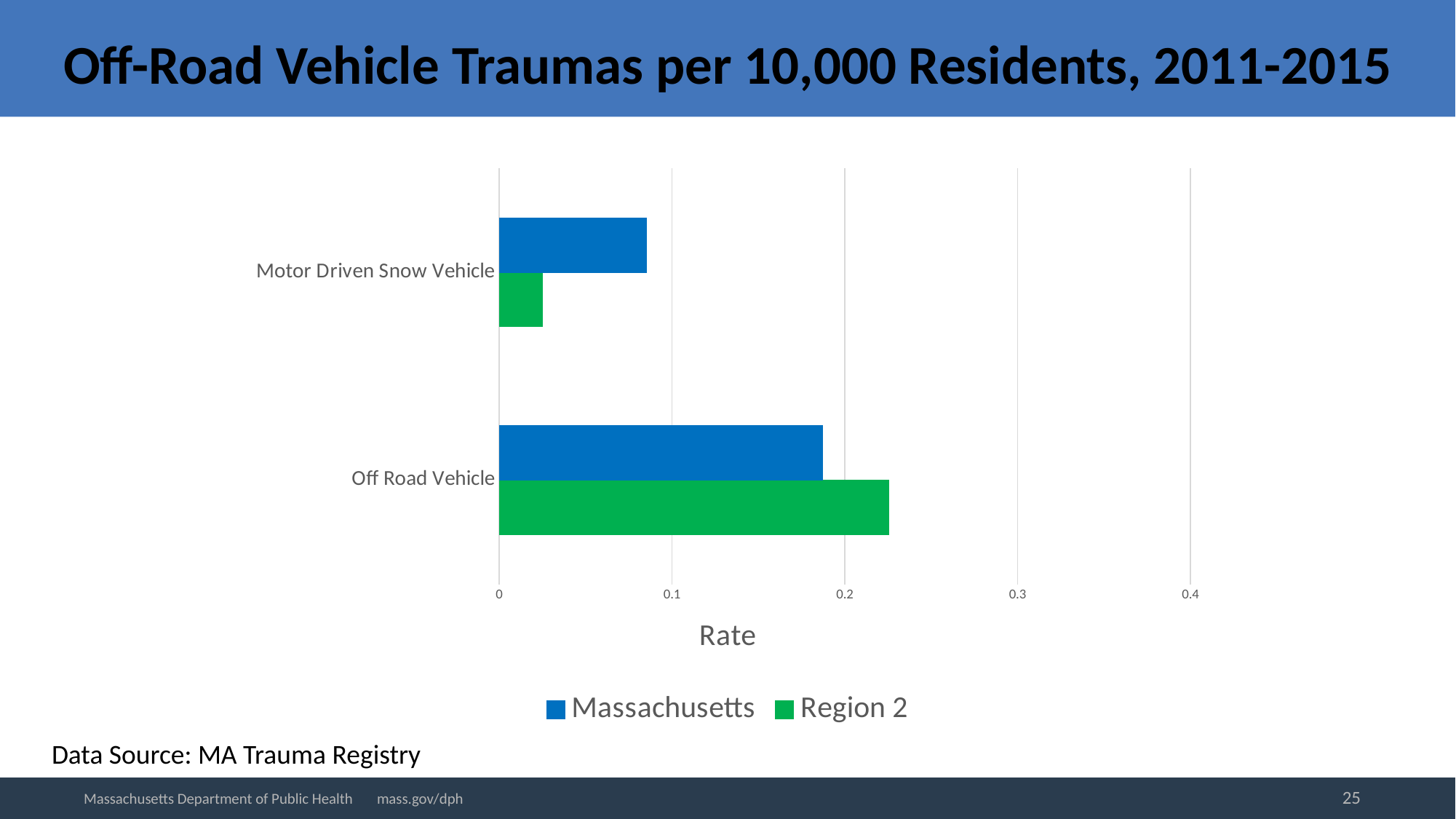
Is the Region 2 value for Motor Driven Snow Vehicle greater or less than 0.1? less Which series does the green bar represent? Region 2 Is the Massachusetts value for Off Road Vehicle greater or less than 0.2? less What kind of chart is shown on the slide? Bar chart How many series does the legend list? 2 Which category has the highest rate for Region 2? Off Road Vehicle For Off Road Vehicle, which is larger: the Massachusetts rate or the Region 2 rate? Region 2 Is the Massachusetts value for Motor Driven Snow Vehicle greater or less than 0.1? less How many categories are shown on the chart? 2 For Motor Driven Snow Vehicle, which is larger: the Massachusetts rate or the Region 2 rate? Massachusetts What is the label of the horizontal axis? Rate